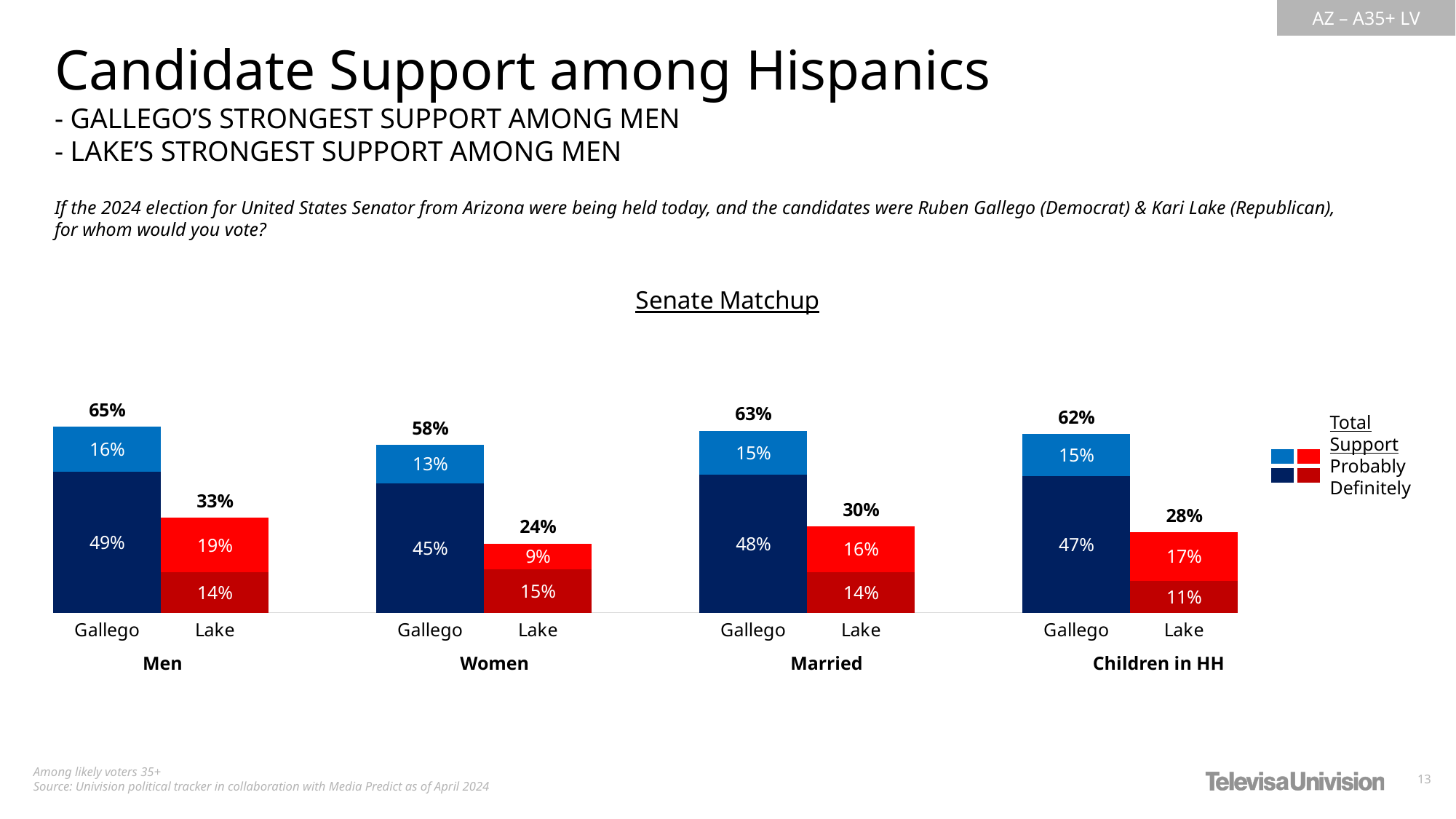
In which group is Gallego's total support highest? Men What two levels of support does the legend distinguish? Probably and Definitely What share of voters with Children in HH say they would probably vote for Lake? 17% What is the total of Lake's stacked bar among Married voters? 30% What is Gallego's total support among Men? 65% In which group is Lake's total support lowest? Women What is the difference between Gallego's and Lake's total support among Men? 32% What share of Married voters say they would definitely vote for Gallego? 48% What kind of chart is shown on the slide? Stacked bar chart How many demographic groups are shown in the chart? 4 Among Married voters, who has higher total support, Gallego or Lake? Gallego What is Lake's total support among Women? 24%